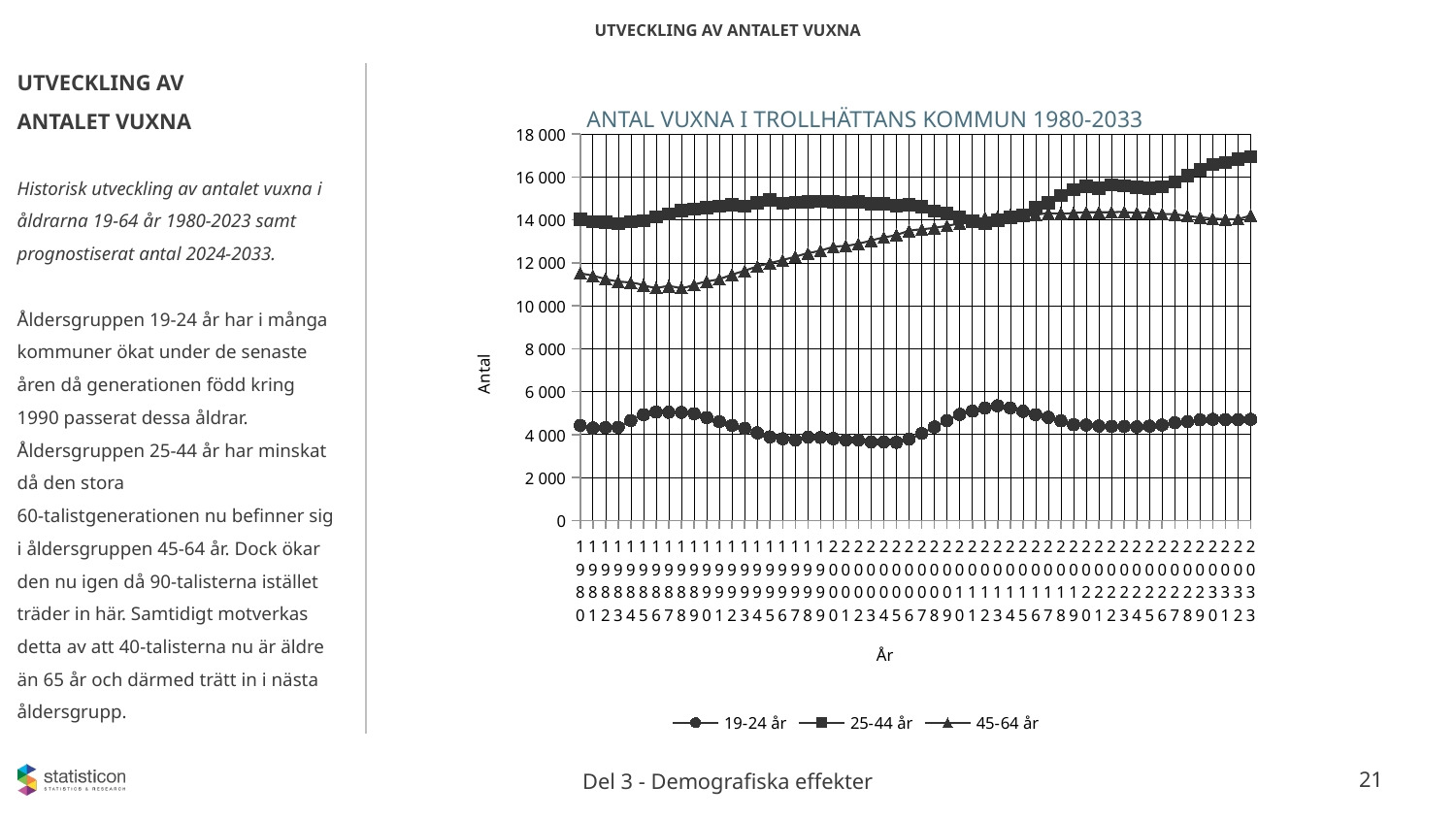
Is the value for 45-64 år in 1980 greater or less than 10 000? greater Is the value for 19-24 år in 1980 greater or less than 6 000? less Which series has the lowest values throughout the chart? 19-24 år Is the value for 25-44 år in 2033 greater or less than 16 000? greater What kind of chart is shown on the slide? Line chart Does the 45-64 år series rise or fall between 1990 and 2010? Rise What is the title of the chart? ANTAL VUXNA I TROLLHÄTTANS KOMMUN 1980-2033 How many years does the x axis of the chart cover? 54 In 2033, which series has the larger value, 25-44 år or 45-64 år? 25-44 år What label is shown on the vertical axis of the chart? Antal How many series does the legend of the chart list? 3